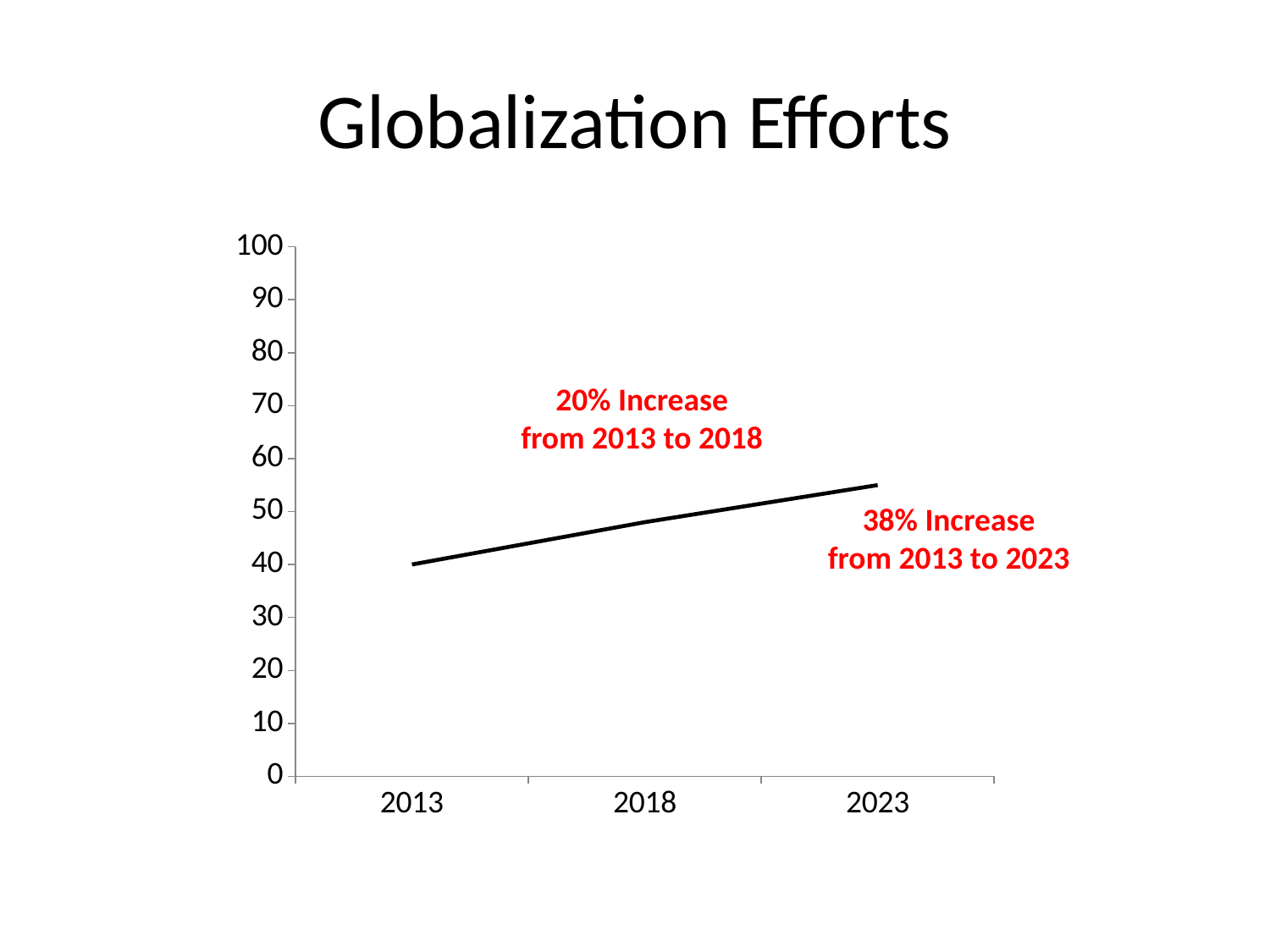
Which year has the highest value? 2023 According to the annotation on the chart, what is the percentage increase from 2013 to 2023? 38% Is the value for 2018 greater or less than 40? greater What is the title of the chart on the slide? Globalization Efforts What kind of chart is shown on the slide? line chart Which year has the lowest value? 2013 What is the value for 2013? 40 Is the value for 2023 greater or less than 50? greater How many data points are plotted on the line? 3 Which is larger, the value for 2018 or the value for 2023? 2023 Do the values rise or fall from 2013 to 2023? rise Is the value for 2018 greater or less than 60? less